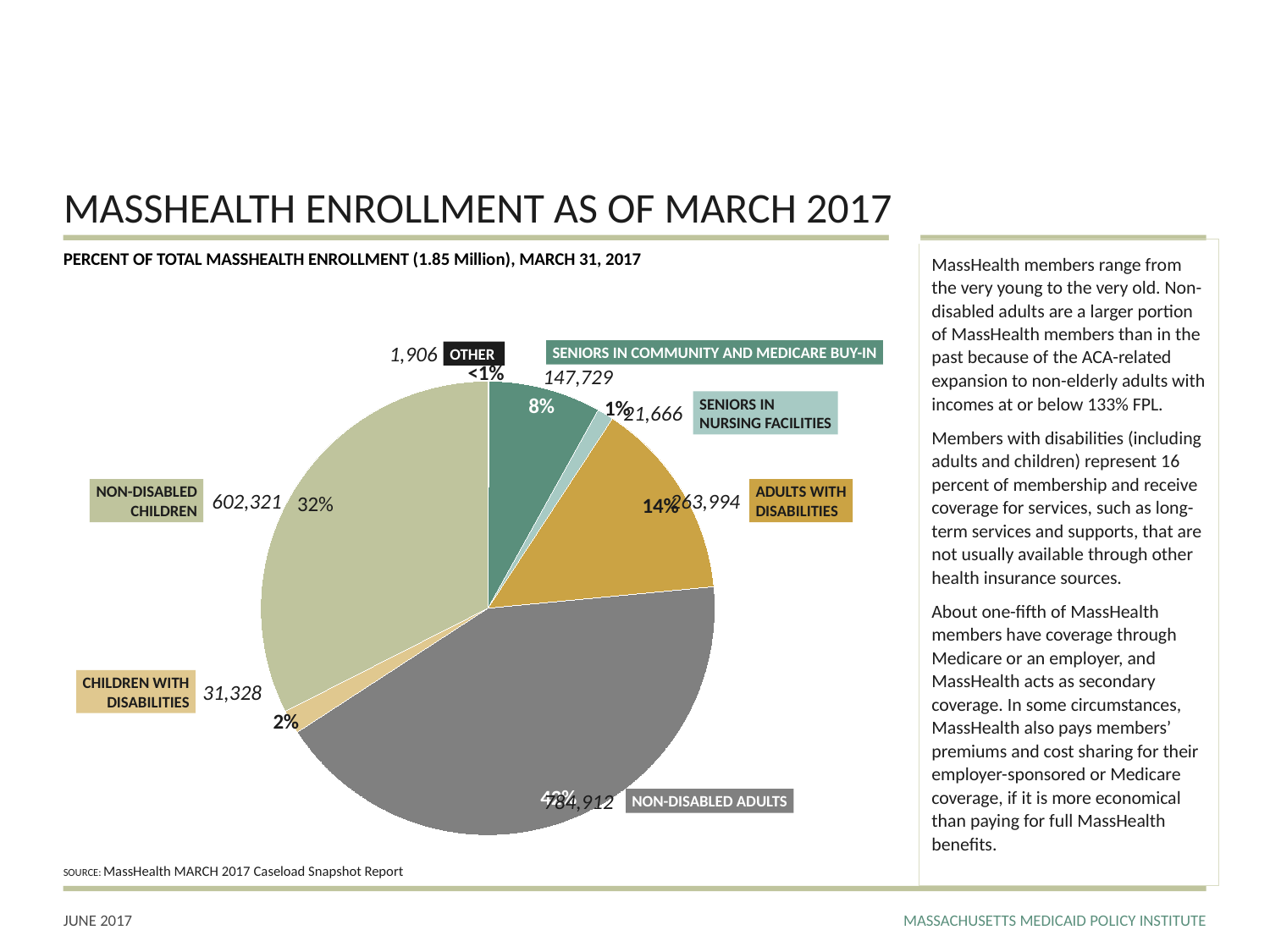
What share of total enrollment do Adults with Disabilities represent? 14% What share of total enrollment do Non-Disabled Children represent? 32% What is the difference in enrollment between Non-Disabled Children and Children with Disabilities? 570,993 How many categories does the pie chart show? 7 Which category has the smallest enrollment in the pie chart? Other What is the enrollment for Seniors in Community and Medicare Buy-In? 147,729 Which category has the largest enrollment in the pie chart? Non-Disabled Adults What kind of chart is shown on the slide? Pie chart Which is larger, the enrollment for Adults with Disabilities or for Seniors in Community and Medicare Buy-In? Adults with Disabilities What is the enrollment for Non-Disabled Children? 602,321 What is the enrollment for Adults with Disabilities? 263,994 What is the enrollment for Children with Disabilities? 31,328